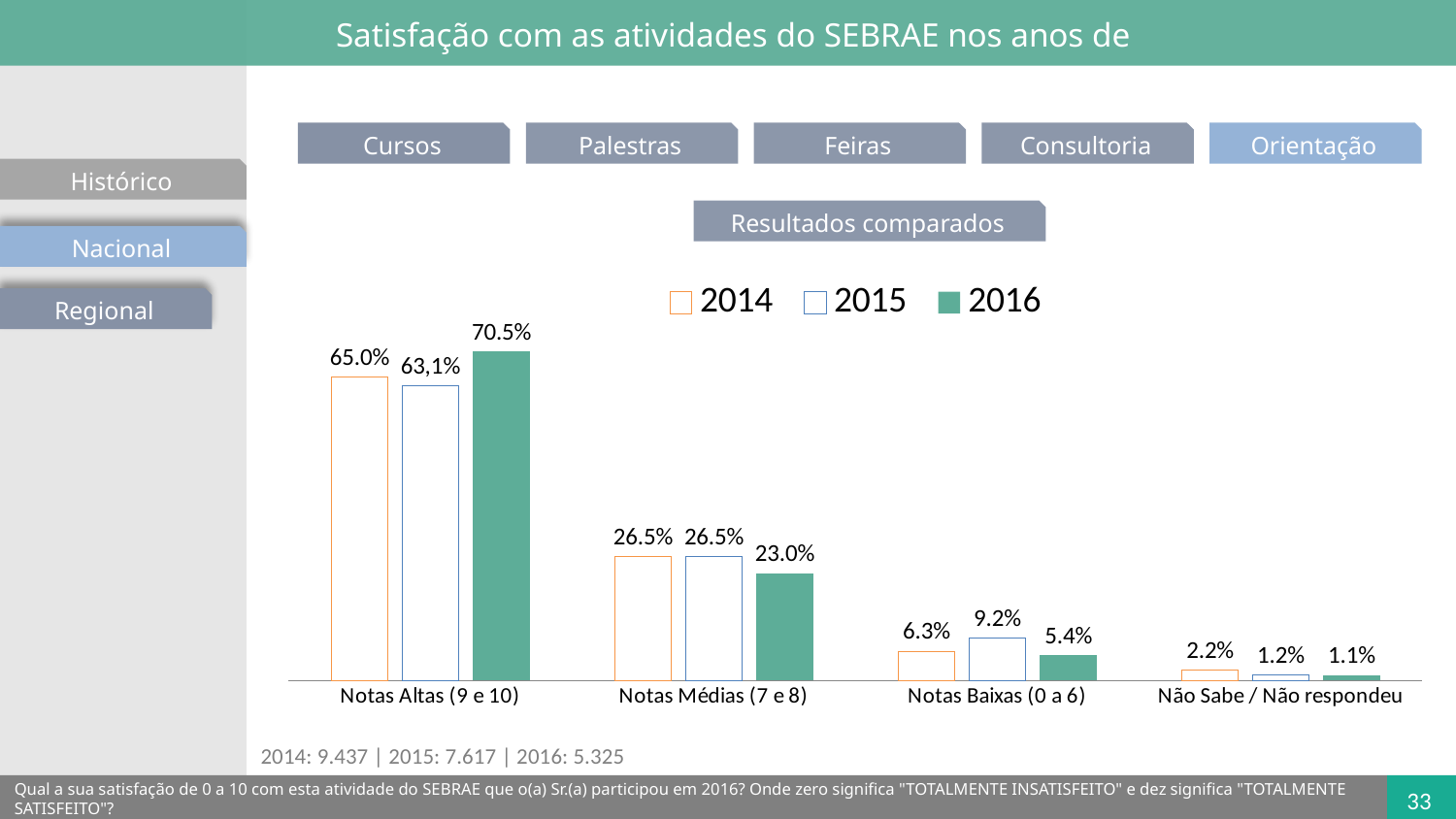
What is the difference between the 2016 and 2014 values in the Notas Altas (9 e 10) category? 5.5% What kind of chart is shown on the slide? Bar chart What is the value for 2014 in the Notas Baixas (0 a 6) category? 6.3% What is the value for 2016 in the Notas Altas (9 e 10) category? 70.5% How many series does the legend list? 3 Which year has the highest value in the Notas Baixas (0 a 6) category? 2015 How many categories are shown on the x axis? 4 What is the value for 2015 in the Notas Altas (9 e 10) category? 63,1% What is the value for 2016 in the Não Sabe / Não respondeu category? 1.1% Which is larger in the Notas Médias (7 e 8) category: the 2014 value or the 2016 value? 2014 Which category has the lowest value for 2014? Não Sabe / Não respondeu Which series is shown with solid green bars in the legend? 2016